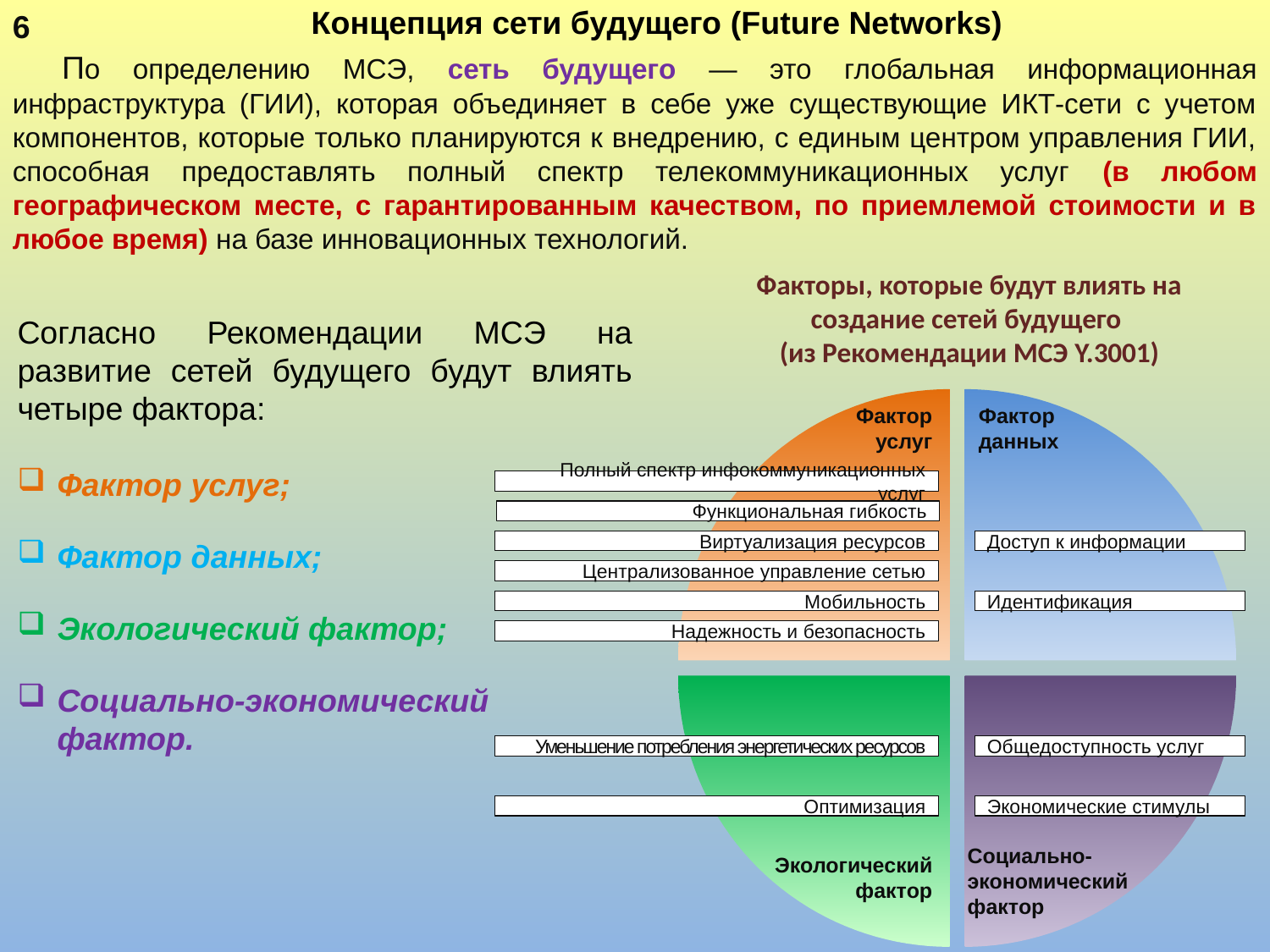
In the diagram, how many items are listed under "Фактор данных"? 2 In the diagram, which factor is the item "Мобильность" listed under? Фактор услуг In the diagram, which factor is the item "Экономические стимулы" listed under? Социально-экономический фактор In the diagram, which factor has the most items listed under it? Фактор услуг In the diagram, what colour is the quadrant for "Экологический фактор"? Green How many factors does the circular diagram on the right divide into? 4 In the diagram, which factor is the item "Идентификация" listed under? Фактор данных In the diagram, how many items are listed under "Фактор услуг"? 6 What is the title of the diagram on the right side of the slide? Факторы, которые будут влиять на создание сетей будущего (из Рекомендации МСЭ Y.3001) In the diagram, which factor is the item "Оптимизация" listed under? Экологический фактор